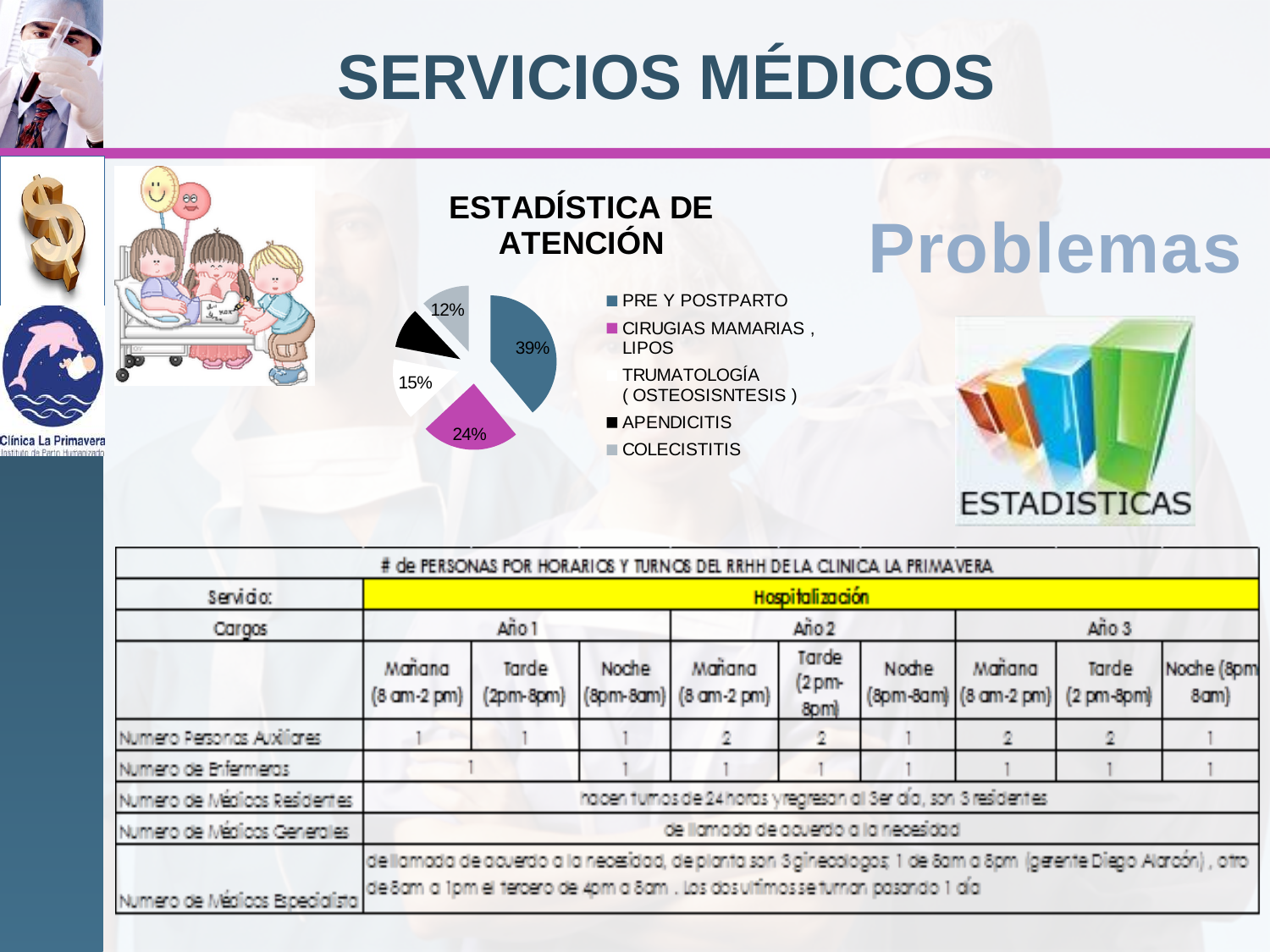
In the ESTADÍSTICA DE ATENCIÓN pie chart, how many percentage points larger is PRE Y POSTPARTO than CIRUGIAS MAMARIAS, LIPOS? 15 In the ESTADÍSTICA DE ATENCIÓN pie chart, what colour is the slice for CIRUGIAS MAMARIAS, LIPOS? Magenta In the ESTADÍSTICA DE ATENCIÓN pie chart, what percentage is shown for CIRUGIAS MAMARIAS, LIPOS? 24% Which category has the largest slice in the ESTADÍSTICA DE ATENCIÓN pie chart? PRE Y POSTPARTO How many categories does the legend of the ESTADÍSTICA DE ATENCIÓN pie chart list? 5 What is the title of the pie chart on the slide? ESTADÍSTICA DE ATENCIÓN In the ESTADÍSTICA DE ATENCIÓN pie chart, which is larger: CIRUGIAS MAMARIAS, LIPOS or APENDICITIS? CIRUGIAS MAMARIAS, LIPOS In the ESTADÍSTICA DE ATENCIÓN pie chart, what percentage is shown for COLECISTITIS? 12% What type of chart is shown under the heading ESTADÍSTICA DE ATENCIÓN? Pie chart In the ESTADÍSTICA DE ATENCIÓN pie chart, what percentage is shown for PRE Y POSTPARTO? 39% What share of the ESTADÍSTICA DE ATENCIÓN pie does PRE Y POSTPARTO represent? 39%